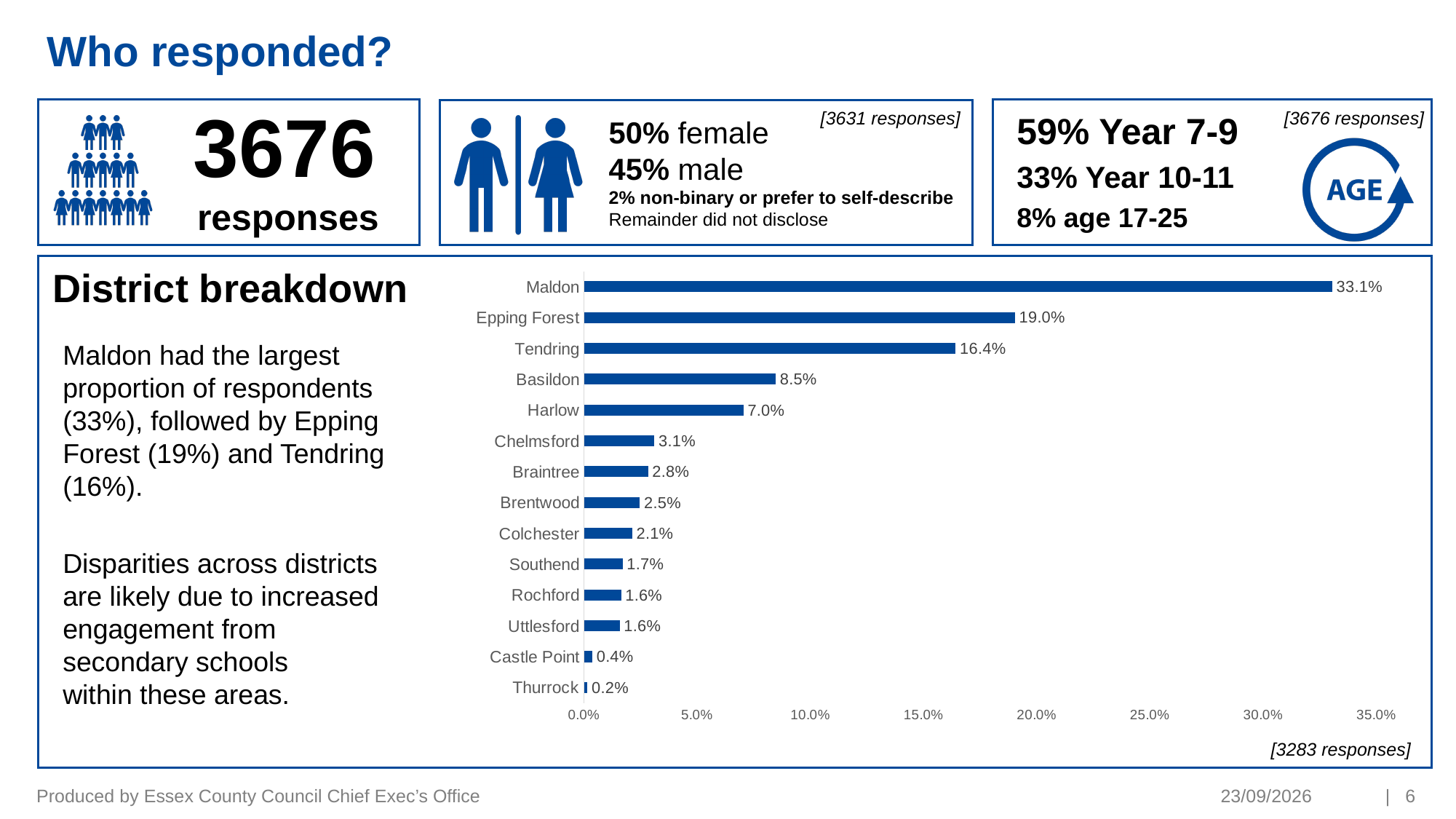
What percentage is shown for Colchester in the District breakdown chart? 2.1% How many responses does the District breakdown chart note it is based on? 3283 responses Is the value for Tendring in the District breakdown chart greater or less than 15.0%? greater In the District breakdown chart, which has a larger value, Harlow or Chelmsford? Harlow Which district has the highest proportion of respondents in the District breakdown chart? Maldon What percentage of respondents were from Maldon in the District breakdown chart? 33.1% How many districts are shown in the District breakdown chart? 14 What type of chart is used for the District breakdown? Bar chart What is the difference between the Maldon and Epping Forest values in the District breakdown chart? 14.1% What is the difference between the Epping Forest and Tendring values in the District breakdown chart? 2.6% Which district has the lowest proportion of respondents in the District breakdown chart? Thurrock What value is shown for Basildon in the District breakdown chart? 8.5%